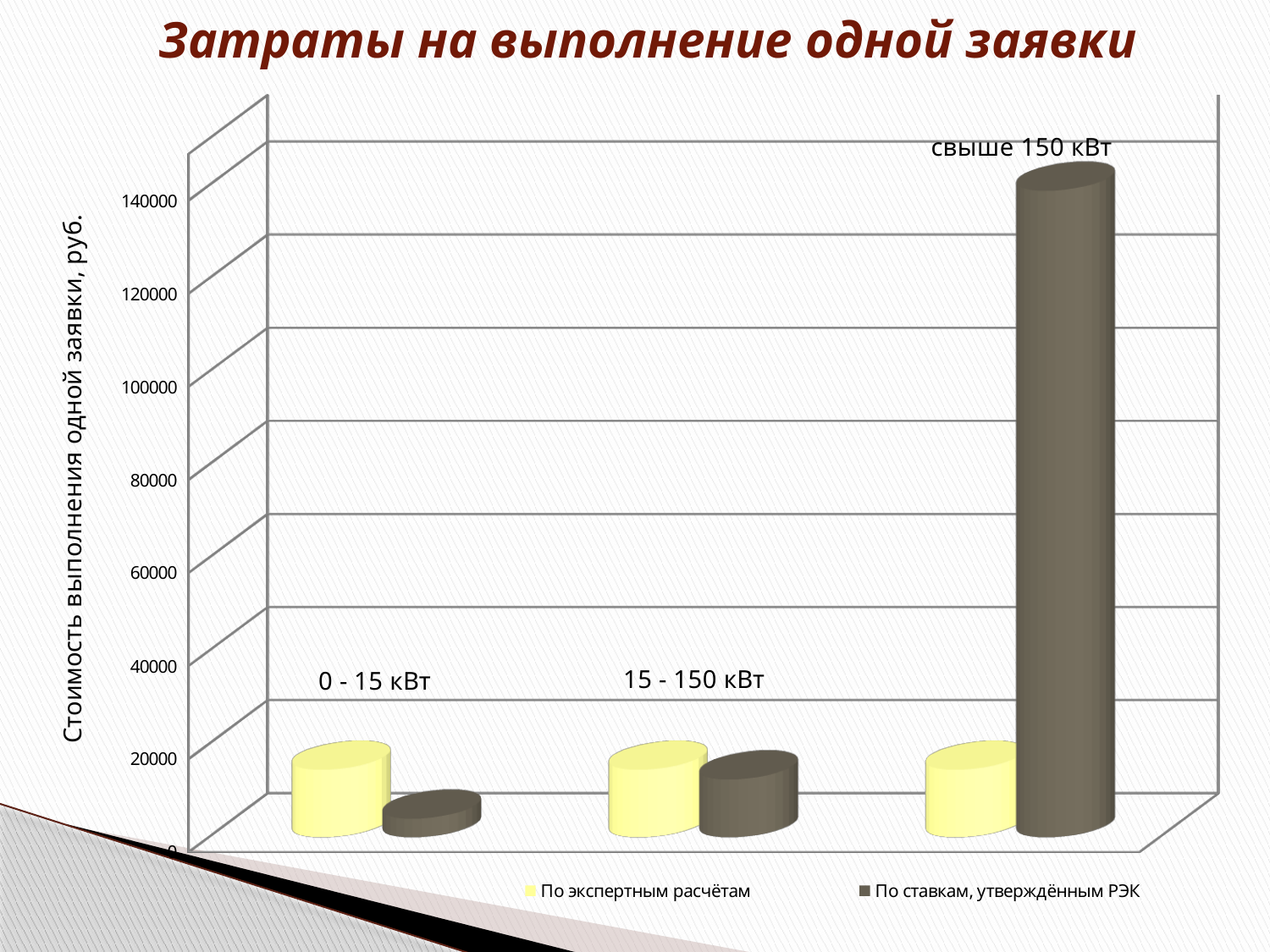
What kind of chart is shown on the slide? bar chart What is the title of the chart? Затраты на выполнение одной заявки Is the value for '15 - 150 кВт' in the series 'По экспертным расчётам' greater or less than 40000? less For the category 'свыше 150 кВт', which series has the larger value: 'По экспертным расчётам' or 'По ставкам, утверждённым РЭК'? По ставкам, утверждённым РЭК For the category '0 - 15 кВт', which series has the larger value: 'По экспертным расчётам' or 'По ставкам, утверждённым РЭК'? По экспертным расчётам For which category is the value of the series 'По ставкам, утверждённым РЭК' the highest? свыше 150 кВт How many series does the legend list? 2 What is the label of the vertical axis? Стоимость выполнения одной заявки, руб. Is the value for '0 - 15 кВт' in the series 'По ставкам, утверждённым РЭК' greater or less than 20000? less For which category is the value of the series 'По ставкам, утверждённым РЭК' the lowest? 0 - 15 кВт How many categories are shown on the x axis? 3 Is the value for 'свыше 150 кВт' in the series 'По ставкам, утверждённым РЭК' greater or less than 120000? greater